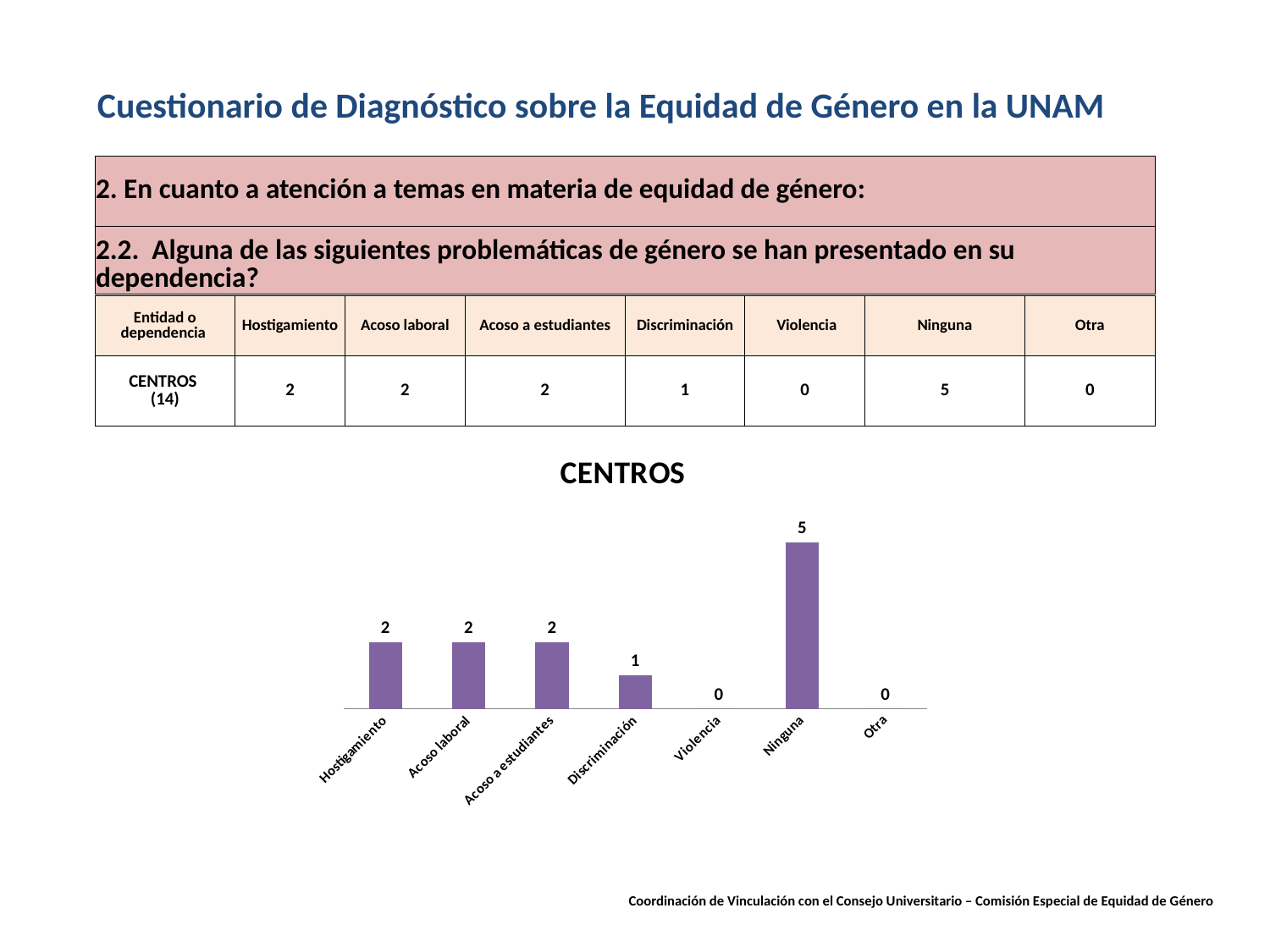
What is the value for Ninguna in the CENTROS chart? 5 What is the difference between the values for Ninguna and Acoso laboral in the CENTROS chart? 3 Which is larger in the CENTROS chart, Acoso a estudiantes or Discriminación? Acoso a estudiantes What is the value for Hostigamiento in the CENTROS chart? 2 What kind of chart is shown on the slide? Bar chart What is the difference between the values for Ninguna and Discriminación in the CENTROS chart? 4 How many categories are shown on the x axis of the CENTROS chart? 7 What is the title of the chart on the slide? CENTROS What is the value for Discriminación in the CENTROS chart? 1 Which category has the highest value in the CENTROS chart? Ninguna What is the value for Violencia in the CENTROS chart? 0 How many categories in the CENTROS chart have a value of 0? 2